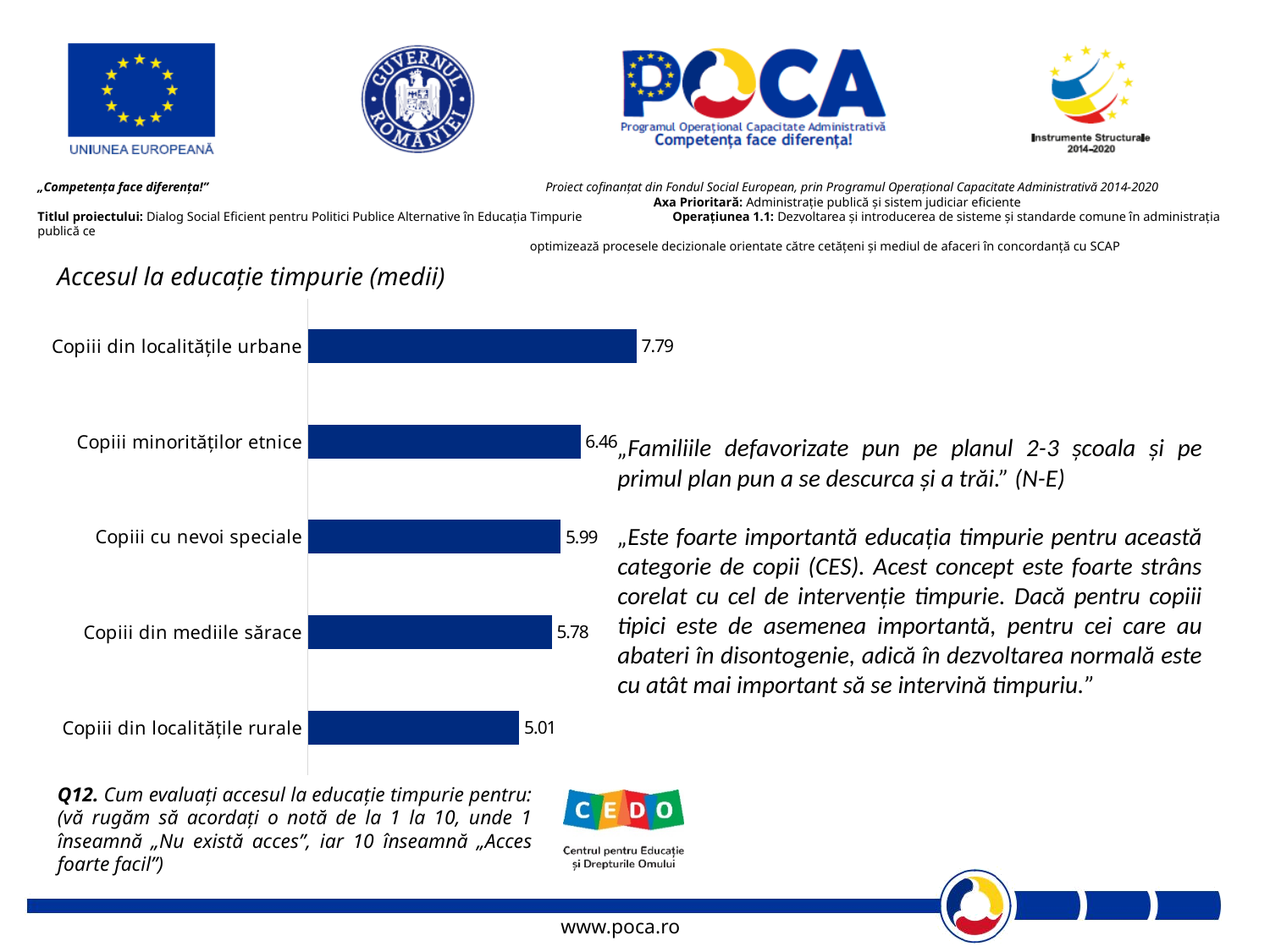
What is the value for Copiii minorităților etnice? 6.46 What is the difference between the values for Copiii din localitățile urbane and Copiii din localitățile rurale? 2.78 What is the value for Copiii cu nevoi speciale? 5.99 Which category has the highest value? Copiii din localitățile urbane What is the value for Copiii din mediile sărace? 5.78 What kind of chart is shown on the slide? Bar chart Which category has the lowest value? Copiii din localitățile rurale What is the value for Copiii din localitățile rurale? 5.01 What is the title of the chart? Accesul la educație timpurie (medii) Which is larger: the value for Copiii cu nevoi speciale or Copiii din mediile sărace? Copiii cu nevoi speciale What is the value for Copiii din localitățile urbane? 7.79 How many categories are shown in the chart? 5